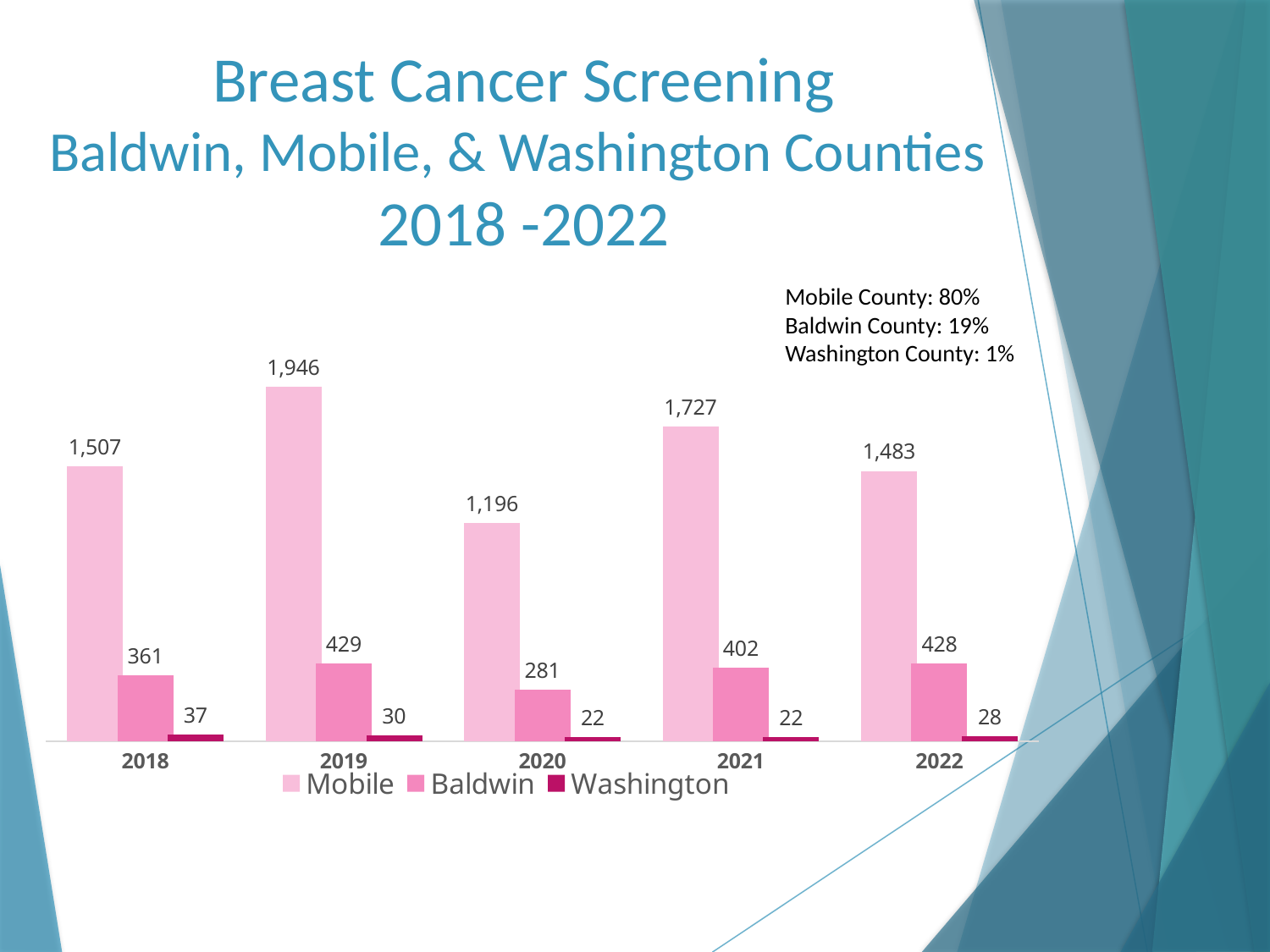
What kind of chart is shown on the slide? bar chart In which year is the Mobile value lowest? 2020 What is the value for Mobile in 2019? 1,946 What is the value for Baldwin in 2020? 281 Which series is shown in the darkest colour in the legend? Washington How many series does the legend list? 3 In which year is the Mobile value highest? 2019 Which is larger, the Baldwin value for 2018 or for 2021? 2021 What is the difference between the Mobile values for 2019 and 2020? 750 What is the value for Washington in 2018? 37 How many years are shown on the x axis? 5 Does the Washington series rise or fall from 2018 to 2020? fall